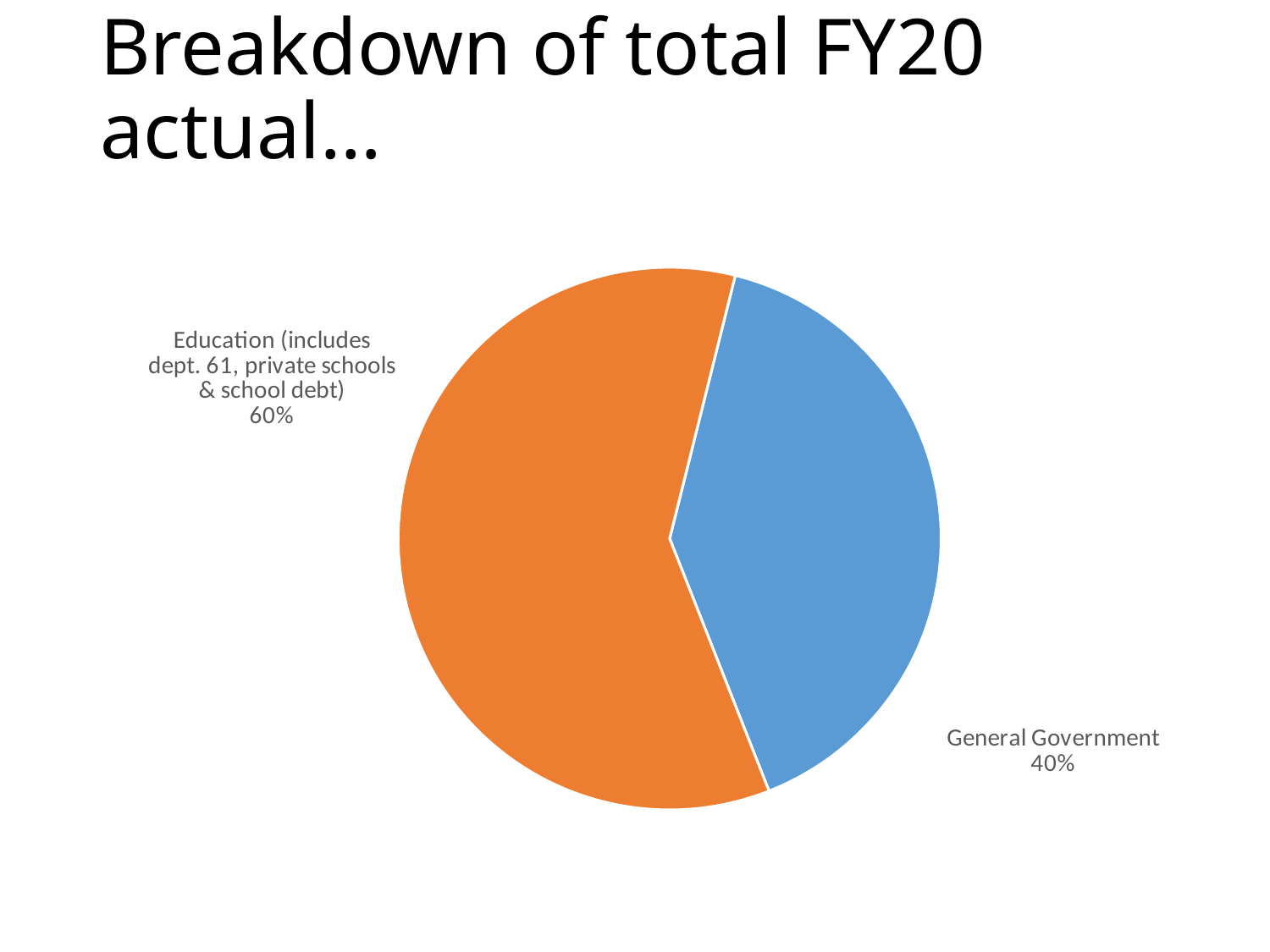
What kind of chart is shown on the slide? pie chart How many slices does the pie chart have? 2 Which slice is the largest? Education (includes dept. 61, private schools & school debt) What is the difference in percentage points between the Education slice and the General Government slice? 20% What colour is the Education slice? orange What share of the pie does General Government represent? 40% What colour is the General Government slice? blue Which slice is the smallest? General Government Which is larger, the Education slice or the General Government slice? Education What share of the pie does Education (includes dept. 61, private schools & school debt) represent? 60%